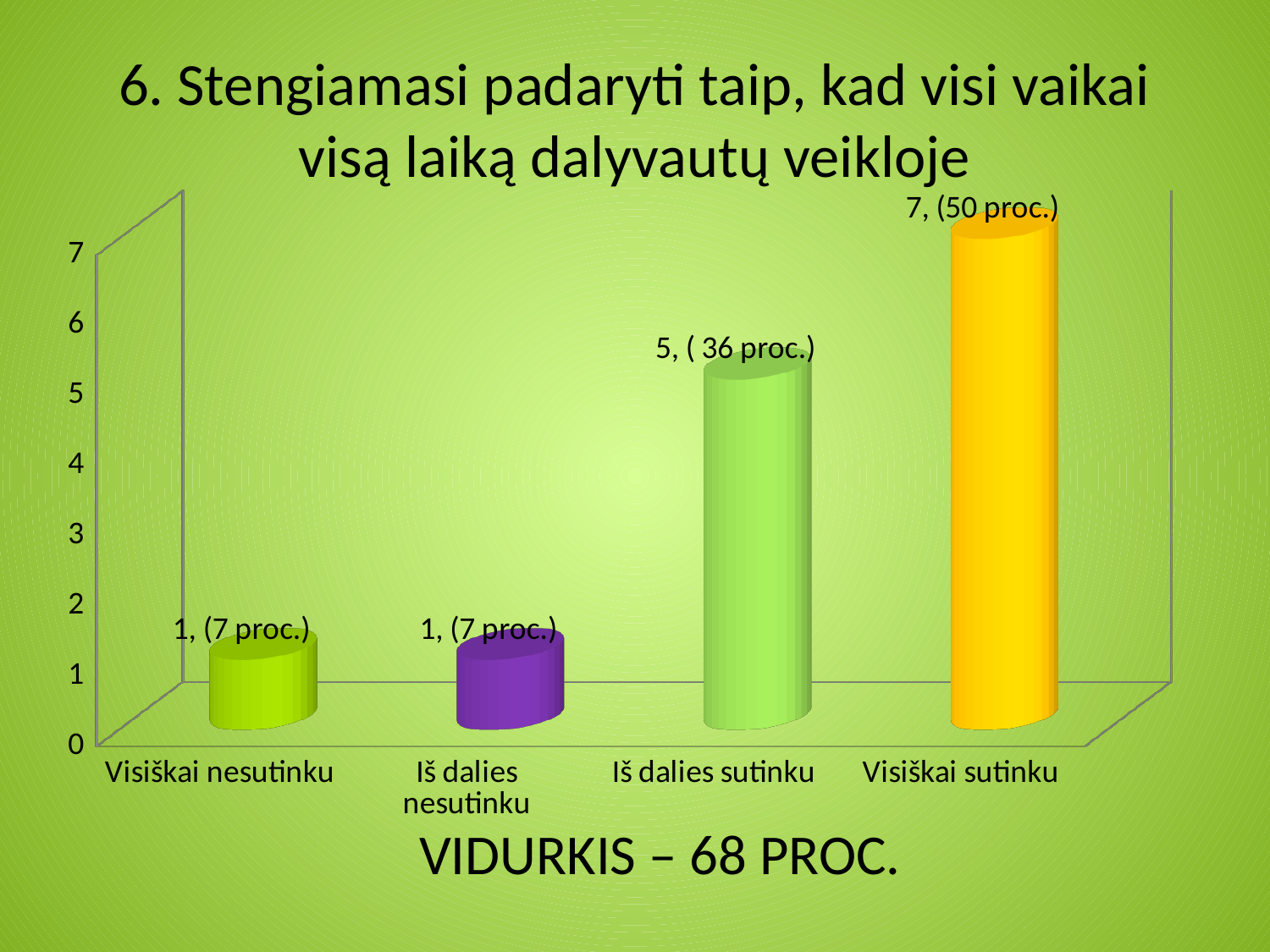
What is the difference between the values for "Visiškai sutinku" and "Iš dalies sutinku"? 2 What is the value for "Visiškai nesutinku"? 1, (7 proc.) What average (VIDURKIS) is stated below the chart? 68 PROC. Is the value for "Visiškai sutinku" greater or less than 6? greater What is the value for "Iš dalies sutinku"? 5, ( 36 proc.) Which category has the highest value? Visiškai sutinku What kind of chart is shown on the slide? bar chart What is the value for "Visiškai sutinku"? 7, (50 proc.) Do the values rise or fall from left to right along the x axis? rise Which is larger, the value for "Iš dalies sutinku" or the value for "Visiškai nesutinku"? Iš dalies sutinku How many categories are shown on the x axis? 4 What is the difference between the values for "Iš dalies sutinku" and "Iš dalies nesutinku"? 4